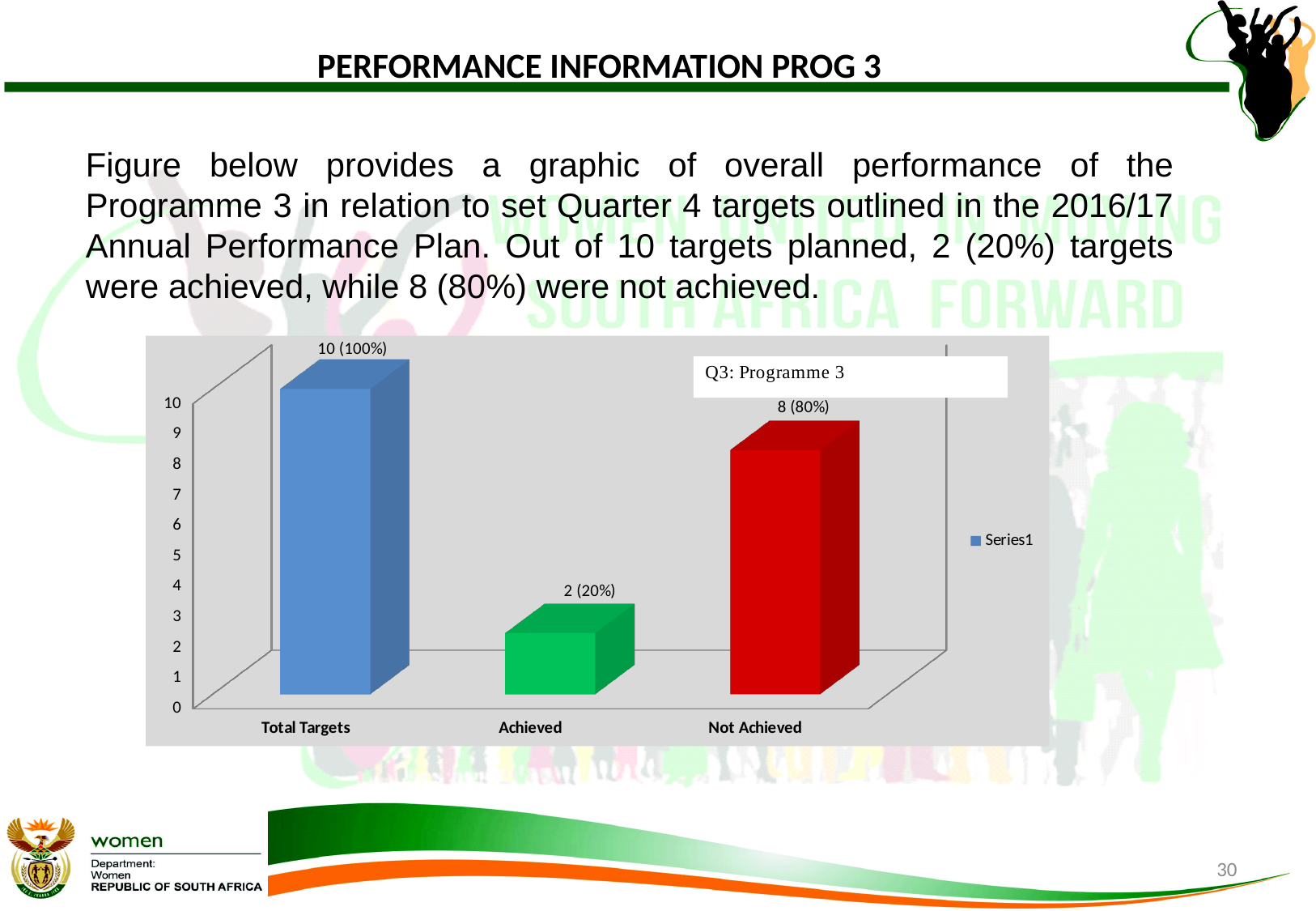
What is the data label on the Achieved bar? 2 (20%) What kind of chart is shown on the slide? Bar chart How many series does the legend list? 1 Which category has the highest bar? Total Targets What is the data label on the Total Targets bar? 10 (100%) Is the value for Not Achieved greater or less than 5? greater Which category has the lowest bar? Achieved How many categories are shown on the x axis? 3 What is the title shown in the chart's text box? Q3: Programme 3 Which is larger, the Achieved value or the Not Achieved value? Not Achieved What is the difference between the Not Achieved value and the Achieved value? 6 What is the data label on the Not Achieved bar? 8 (80%)